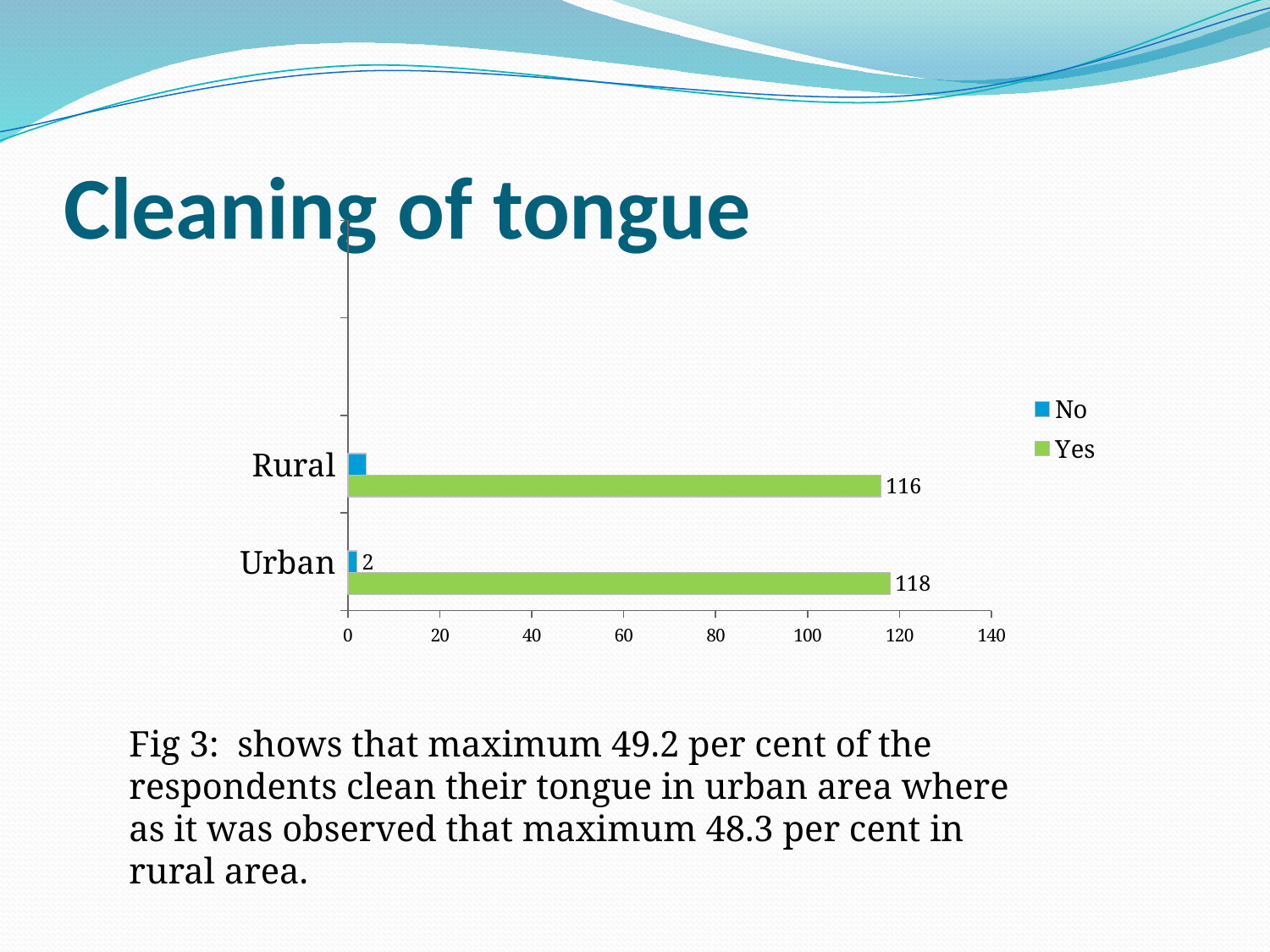
Is the value of the No series for Rural greater or less than 20? less What is the value of the No series for Urban? 2 Which category has the highest Yes value? Urban How many categories are shown on the chart? 2 How many series does the legend list? 2 What is the difference between the Yes values for Urban and Rural? 2 What kind of chart is shown on the slide? bar chart What is the value of the Yes series for Rural? 116 What are the entries in the chart's legend? No, Yes Which category has the higher Yes value, Rural or Urban? Urban What is the value of the Yes series for Urban? 118 What is the difference between the Yes and No values for Urban? 116